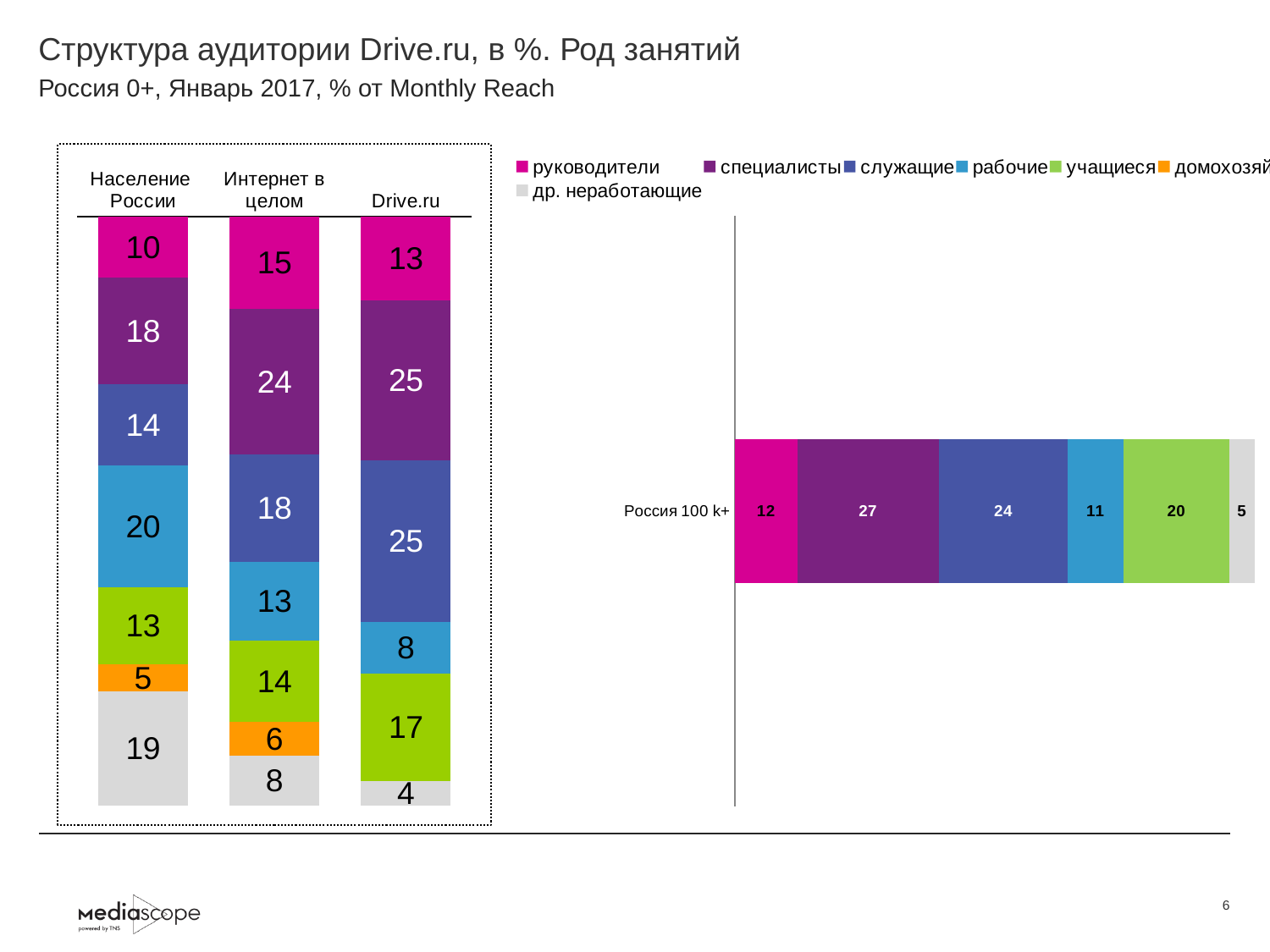
In the left chart, what is the difference between the руководители values for Интернет в целом and Население России? 5 What type of chart is the right chart (Россия 100 k+)? Stacked bar chart In the right chart (Россия 100 k+), what is the value for специалисты? 27 In the left chart, what is the value for рабочие in the Население России column? 20 In the right chart (Россия 100 k+), what is the value for учащиеся? 20 In the left chart, which category has the largest value in the Население России column? рабочие In the left chart, what is the value for др. неработающие in the Интернет в целом column? 8 In the left chart, which category has the smallest value in the Drive.ru column? др. неработающие How many columns (categories) are shown in the left chart? 3 How many series does the legend list? 7 In the left chart, which is larger: учащиеся for Drive.ru or учащиеся for Интернет в целом? Drive.ru In the left chart, what is the value for специалисты in the Drive.ru column? 25